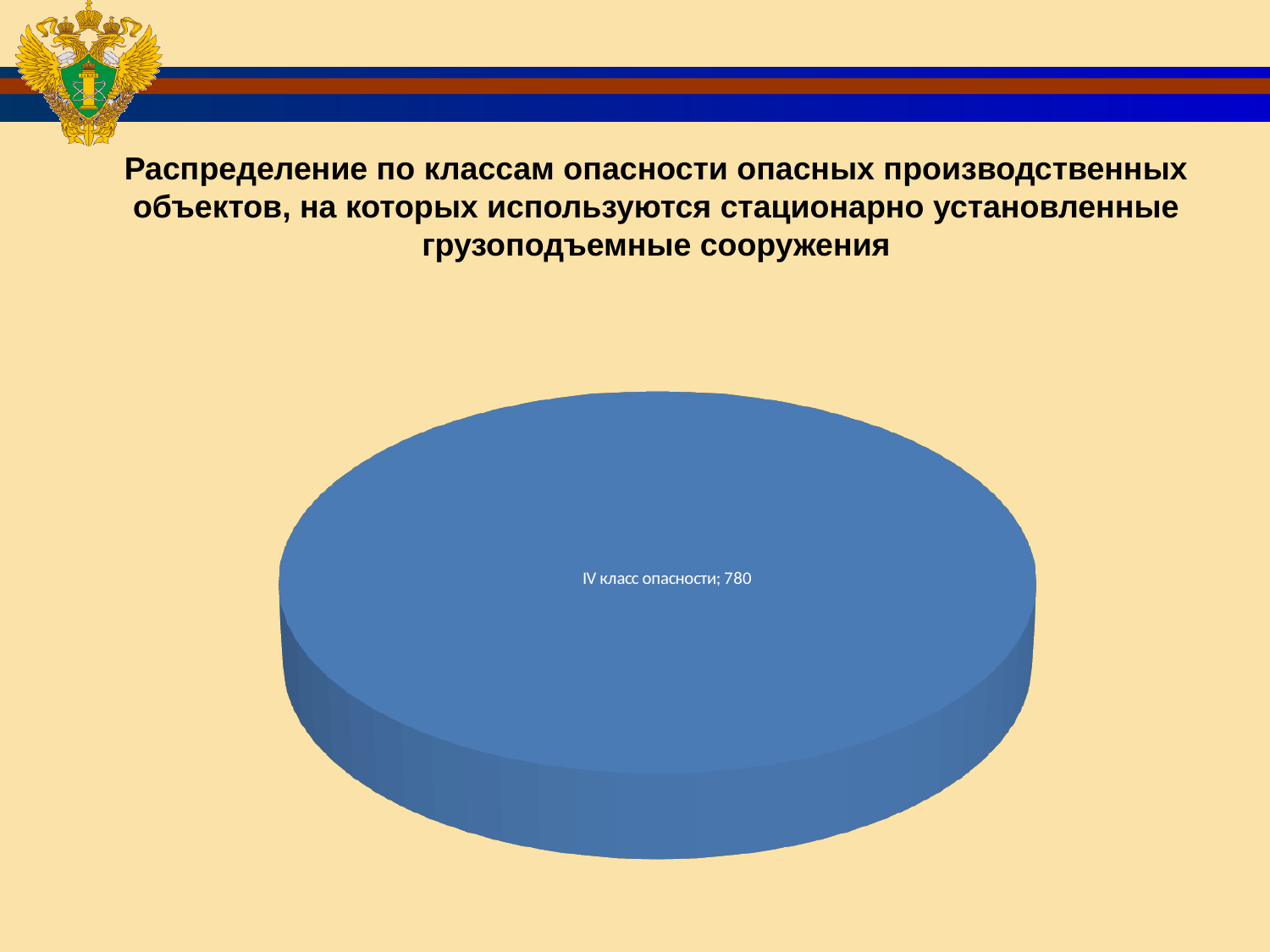
What is the label of the only slice in the pie chart? IV класс опасности Is the value for IV класс опасности greater or less than 500? greater What kind of chart is shown on the slide? pie chart What colour is the slice in the pie chart? blue Which category has the largest slice in the pie chart? IV класс опасности What share of the pie does the IV класс опасности slice represent? 100% What value is shown for IV класс опасности in the pie chart? 780 How many slices does the pie chart contain? 1